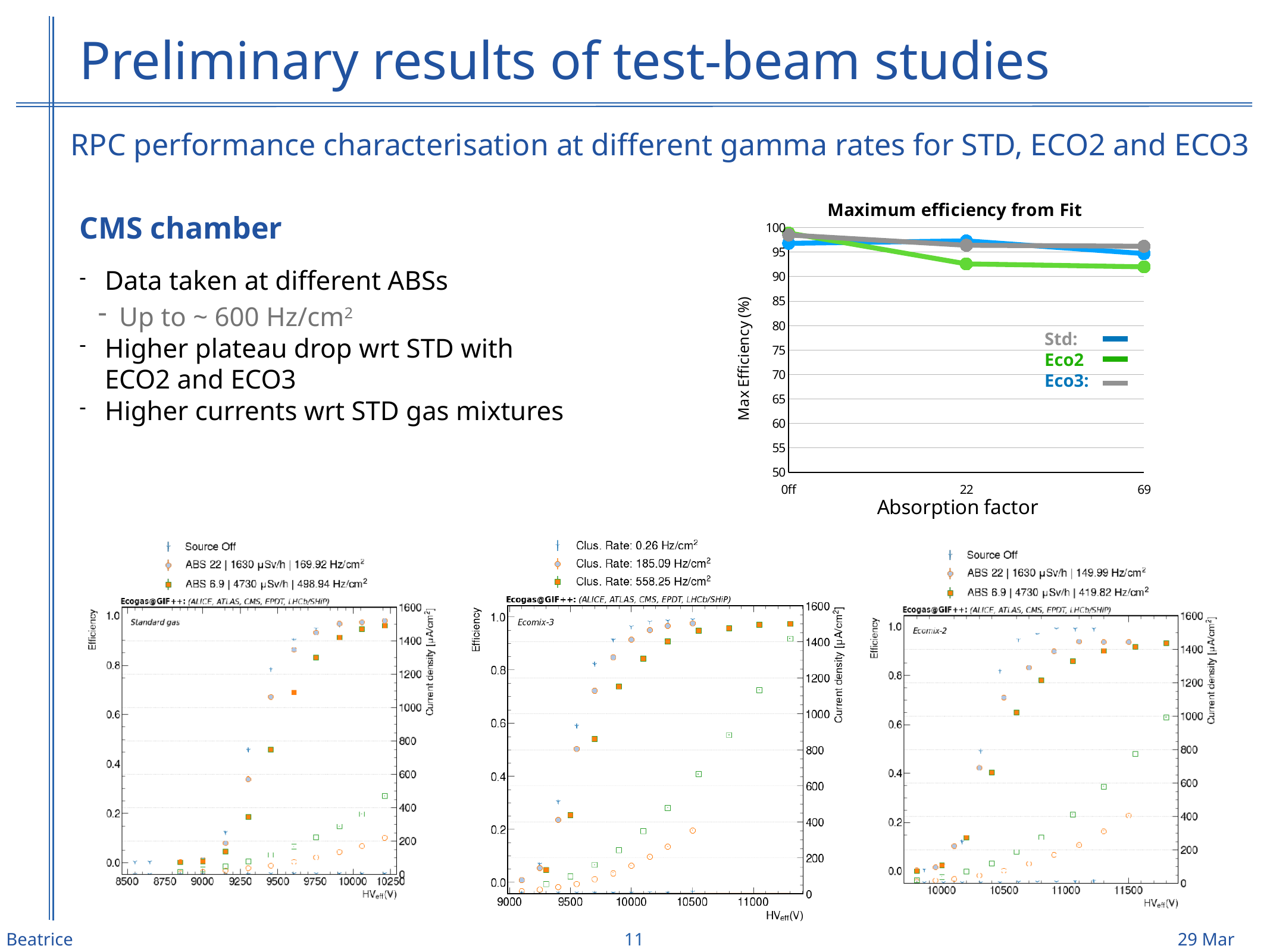
How many absorption factor categories are shown on the x axis of the 'Maximum efficiency from Fit' chart? 3 In the 'Maximum efficiency from Fit' chart, which series has the lowest max efficiency at absorption factor 69? Eco2 In the 'Maximum efficiency from Fit' chart, which series has the lowest max efficiency at absorption factor Off? Std In the 'Maximum efficiency from Fit' chart, is the Eco2 value at absorption factor Off greater or less than 95? greater How many series does the legend of the 'Maximum efficiency from Fit' chart list? 3 In the 'Maximum efficiency from Fit' chart, is the Eco2 value at absorption factor 69 greater or less than 95? less In the 'Maximum efficiency from Fit' chart, at absorption factor 22, which is larger: the Eco2 value or the Eco3 value? Eco3 In the 'Maximum efficiency from Fit' chart, does the Eco2 series rise or fall as the absorption factor increases from Off to 69? fall What kind of chart is the 'Maximum efficiency from Fit' chart? line chart What is the y-axis label of the 'Maximum efficiency from Fit' chart? Max Efficiency (%) In the 'Maximum efficiency from Fit' chart, is the Eco3 value at absorption factor 69 greater or less than 90? greater In the 'Maximum efficiency from Fit' chart, what colour is the Eco2 series line? green